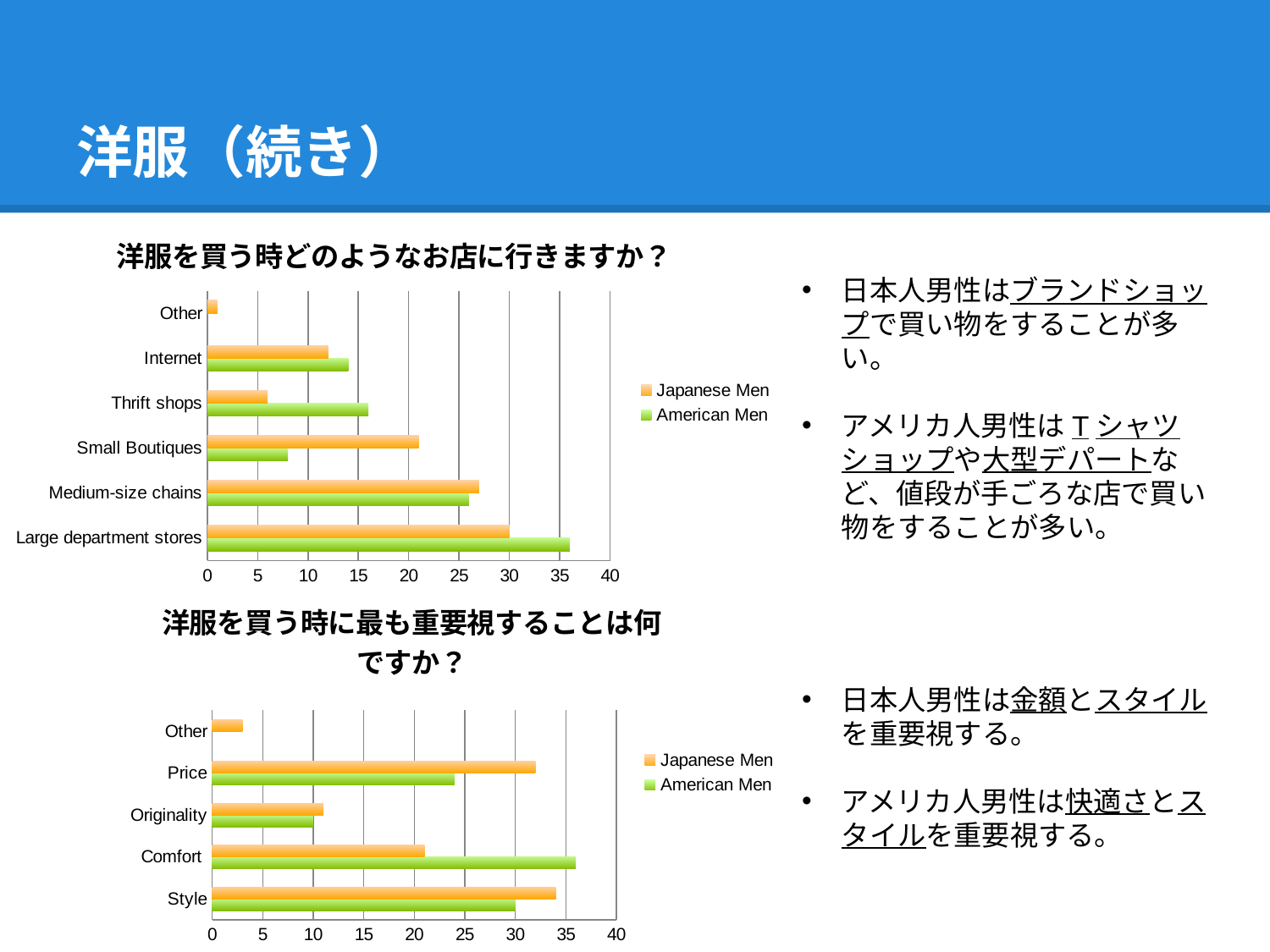
In the top chart (洋服を買う時どのようなお店に行きますか？), for Thrift shops, which series has the larger value, Japanese Men or American Men? American Men In the bottom chart (洋服を買う時に最も重要視することは何ですか？), for Price, which series has the larger value, Japanese Men or American Men? Japanese Men In the top chart (洋服を買う時どのようなお店に行きますか？), is the value for Small Boutiques for Japanese Men greater or less than 15? greater In the bottom chart (洋服を買う時に最も重要視することは何ですか？), how many categories are shown? 5 In the bottom chart (洋服を買う時に最も重要視することは何ですか？), what are the two legend entries? Japanese Men, American Men In the bottom chart (洋服を買う時に最も重要視することは何ですか？), which category has the highest value for American Men? Comfort What kind of chart is the top chart (洋服を買う時どのようなお店に行きますか？)? bar chart In the top chart (洋服を買う時どのようなお店に行きますか？), how many series does the legend list? 2 In the top chart (洋服を買う時どのようなお店に行きますか？), which category has the highest value for American Men? Large department stores In the top chart (洋服を買う時どのようなお店に行きますか？), how many store categories are shown? 6 In the top chart (洋服を買う時どのようなお店に行きますか？), is the value for Large department stores for American Men greater or less than 30? greater In the bottom chart (洋服を買う時に最も重要視することは何ですか？), which category has the lowest value for Japanese Men? Other